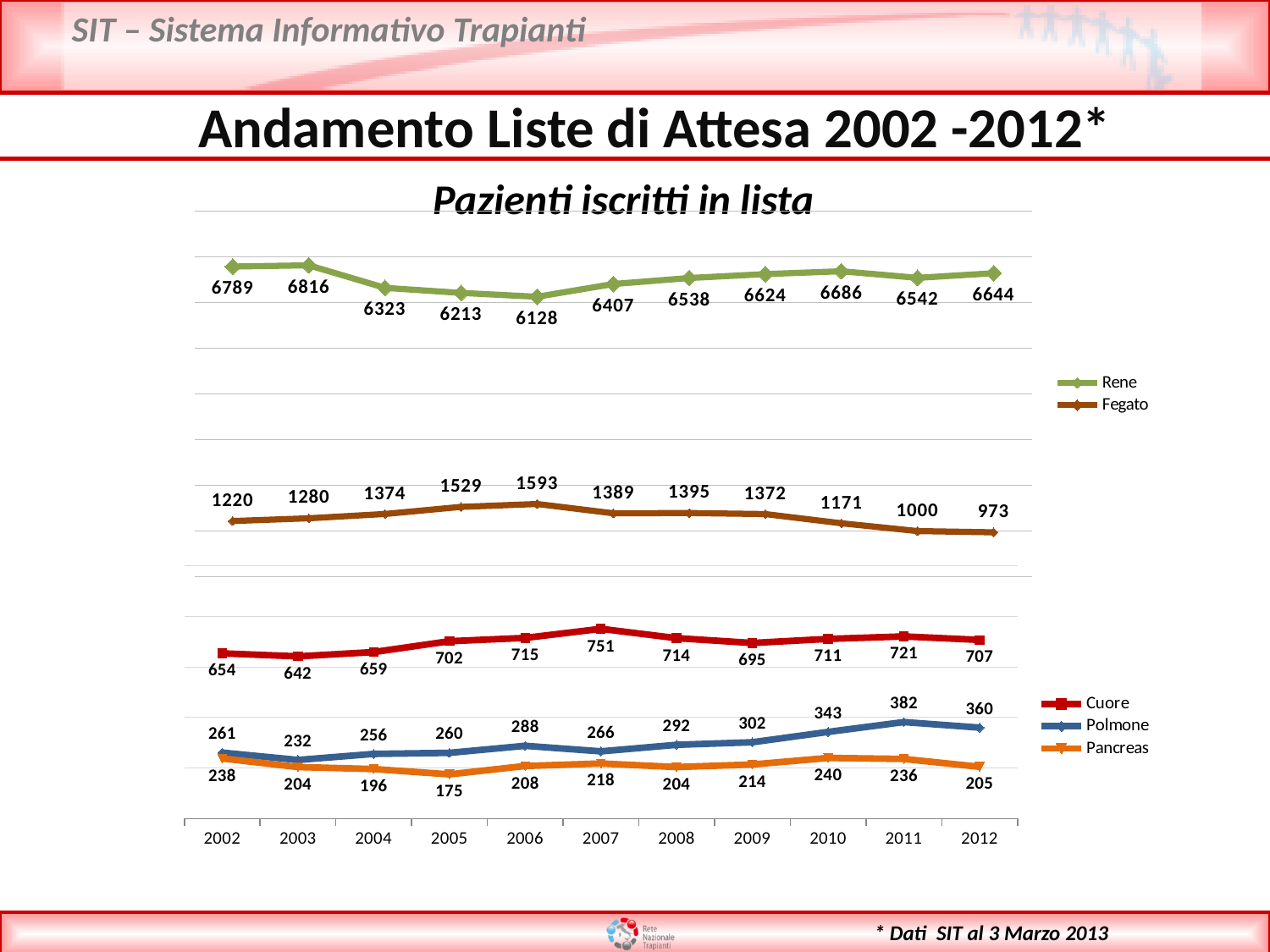
In the 'Pazienti iscritti in lista' chart, what colour is the Rene line? green In the 'Pazienti iscritti in lista' chart, in which year does the Fegato series reach its highest value? 2006 In the 'Pazienti iscritti in lista' chart, which is larger: the Cuore value in 2007 or the Cuore value in 2012? 2007 In the 'Pazienti iscritti in lista' chart, how many years are shown on the x axis? 11 In the 'Pazienti iscritti in lista' chart, what is the difference between the Rene values in 2003 and 2006? 688 In the 'Pazienti iscritti in lista' chart, in which year is the Pancreas value lowest? 2005 In the 'Pazienti iscritti in lista' chart, what is the value for Rene in 2006? 6128 In the 'Pazienti iscritti in lista' chart, does the Fegato series rise or fall from 2009 to 2012? fall In the 'Pazienti iscritti in lista' chart, how many series does the legend with Cuore, Polmone and Pancreas list? 3 In the 'Pazienti iscritti in lista' chart, what is the value for Fegato in 2012? 973 What kind of chart is 'Pazienti iscritti in lista'? line chart In the 'Pazienti iscritti in lista' chart, what is the value for Polmone in 2011? 382